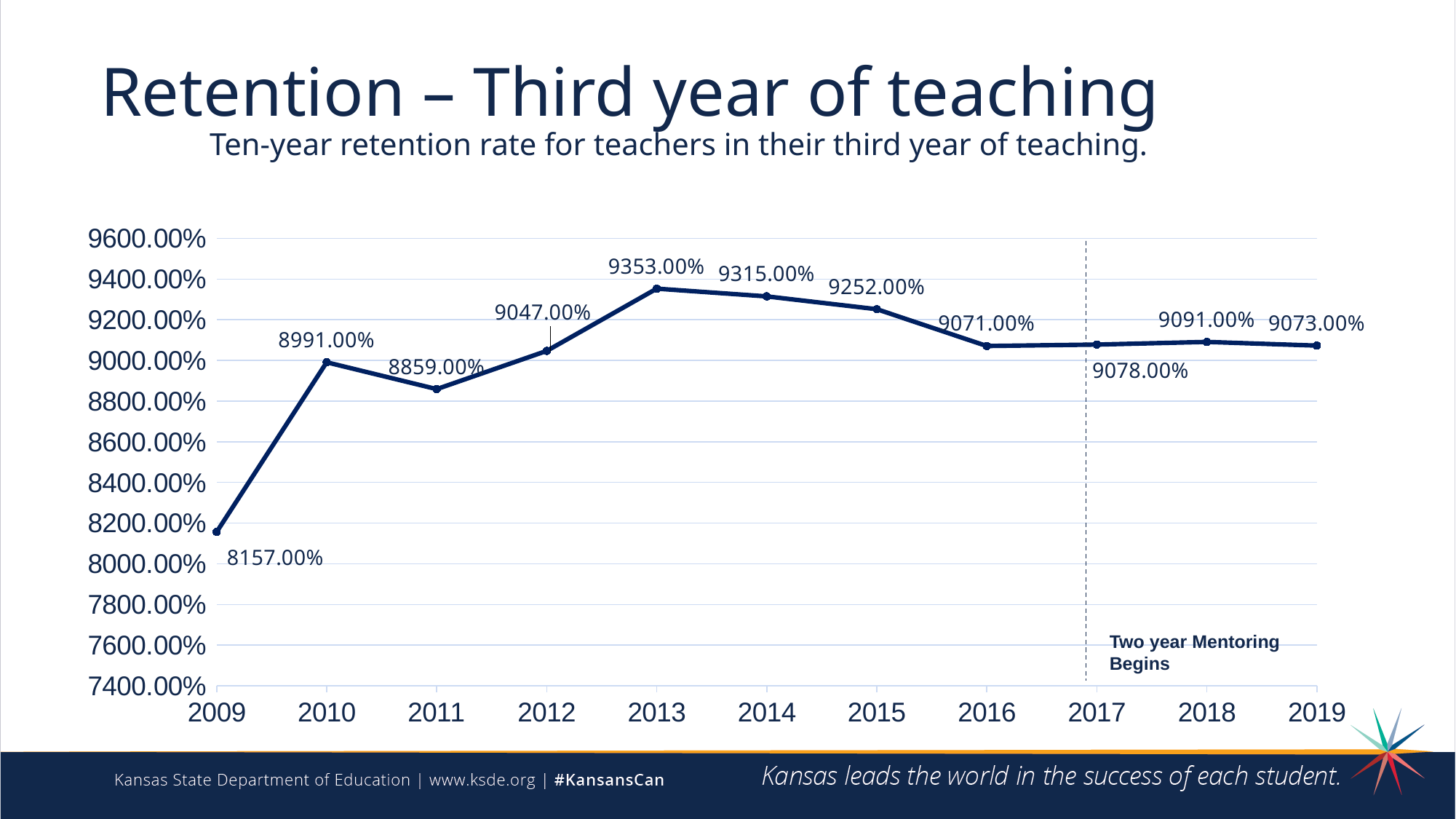
What is the retention rate value shown for 2009? 8157.00% What is the difference between the values for 2013 and 2009? 1196.00% What event does the dashed vertical line at 2017 mark? Two year Mentoring Begins What kind of chart is shown on the slide? line chart Is the value for 2012 greater or less than 9000.00%? greater What is the value shown for 2013? 9353.00% How many years are plotted on the x axis? 11 What is the value shown for 2017? 9078.00% Do the values rise or fall from 2013 to 2016? fall Which year has the larger value, 2010 or 2011? 2010 Which year has the highest value on the chart? 2013 Which year has the lowest value on the chart? 2009